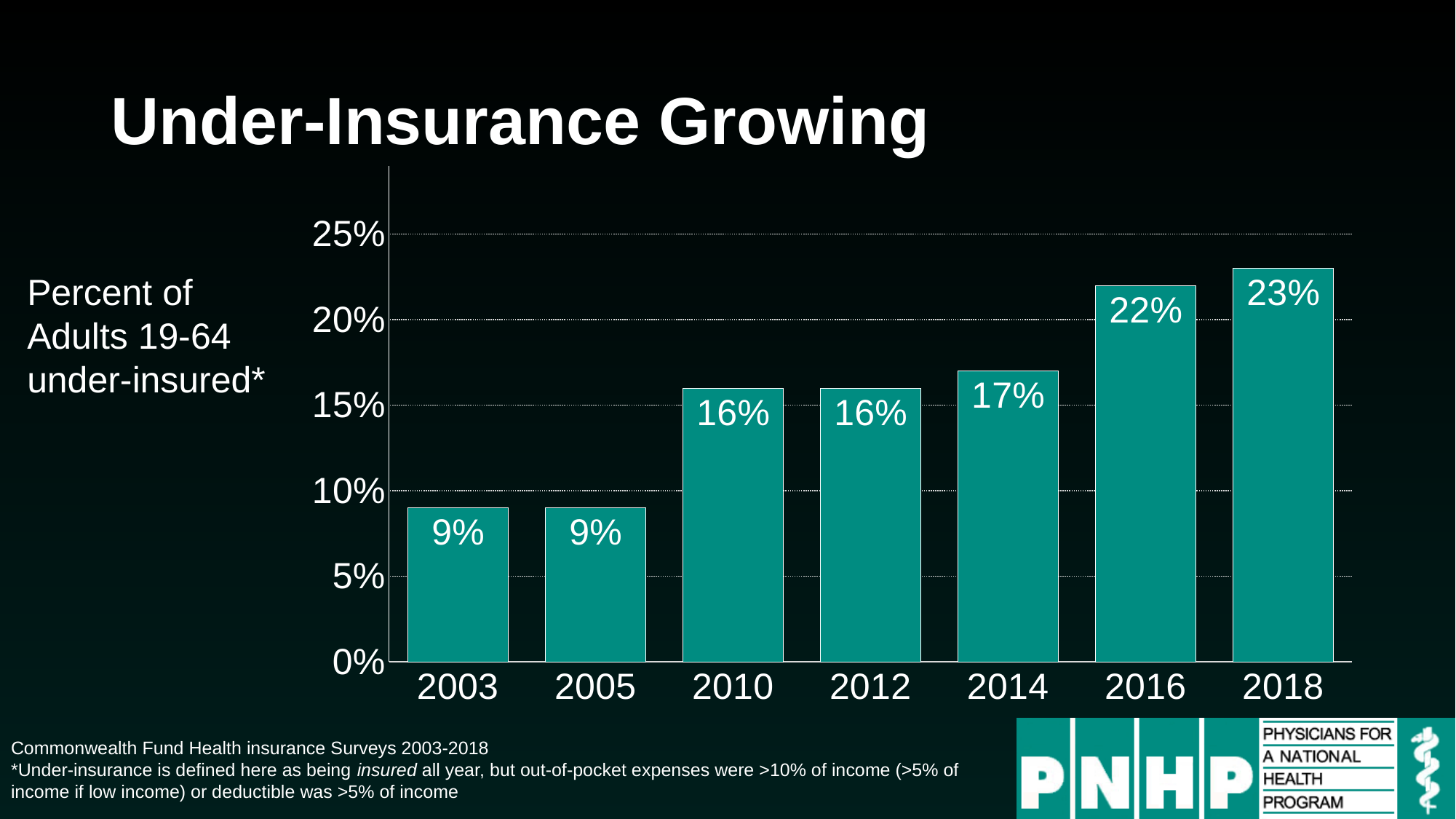
Which is larger, the value for 2010 or the value for 2016? 2016 Do the values generally rise or fall from 2003 to 2018? Rise What is the difference between the values for 2018 and 2003? 14% Which year has the highest percentage of under-insured adults? 2018 What is the value shown for 2014? 17% What is the value shown for 2018? 23% What percent of adults 19-64 were under-insured in 2003? 9% How many years are shown on the x axis? 7 What kind of chart is shown on the slide? Bar chart What is the difference between the values for 2016 and 2014? 5% Is the value for 2016 greater or less than 20%? greater What is the title of the slide? Under-Insurance Growing